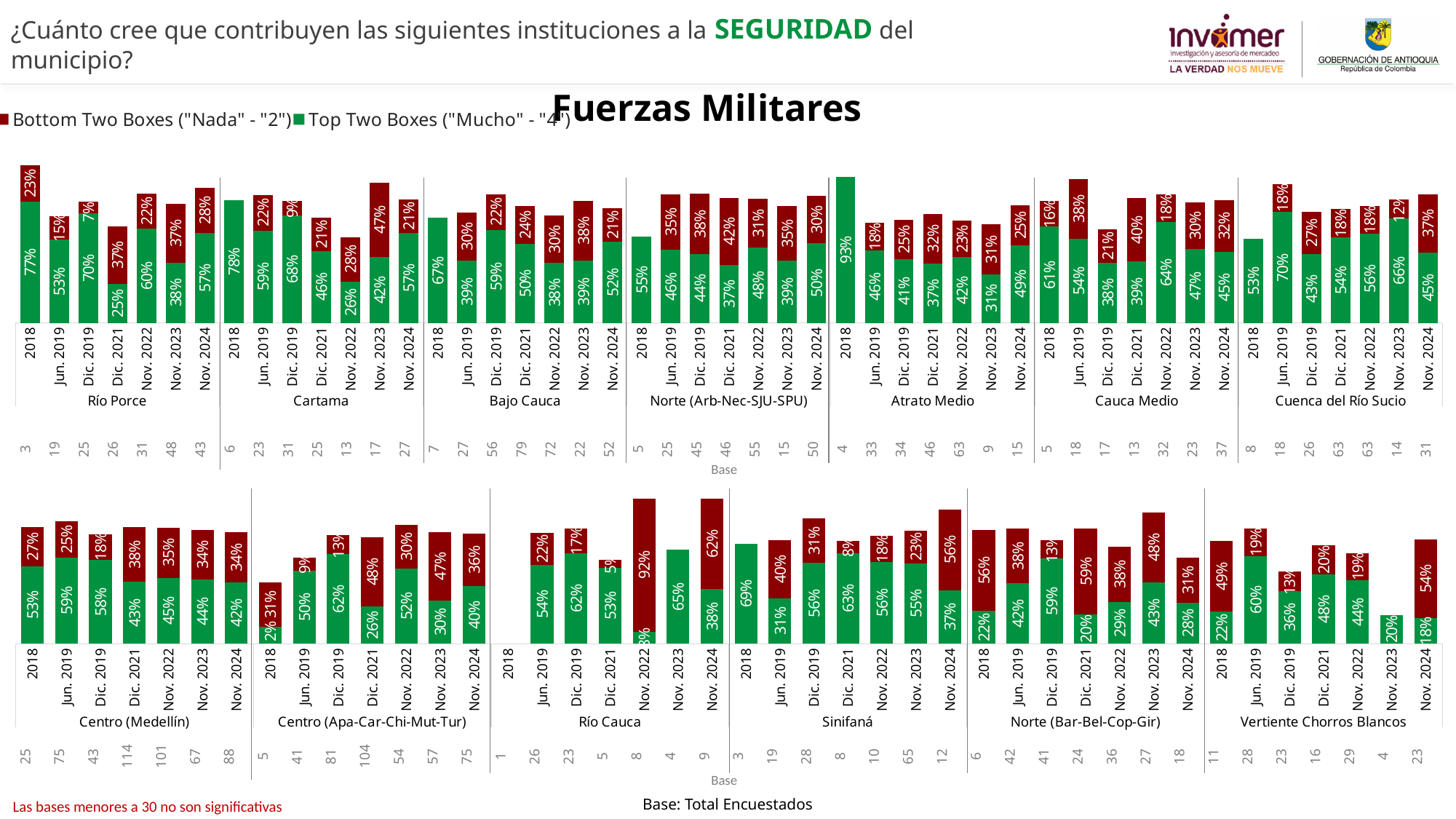
In the top chart, what is the Bottom Two Boxes value for Cartama in Nov. 2023? 47% In the top chart, what is the Top Two Boxes value for Atrato Medio in 2018? 93% In the bottom chart, which period has the lowest Top Two Boxes value for Centro (Apa-Car-Chi-Mut-Tur)? 2018 Which colour represents Top Two Boxes ("Mucho" - "4") in the legend? Green In the top chart, which is larger for Cauca Medio in Dic. 2021: the Top Two Boxes value or the Bottom Two Boxes value? Bottom Two Boxes How many series does the legend list? 2 In the bottom chart, what is the Top Two Boxes value for Sinifaná in Dic. 2021? 63% In the top chart, which period has the highest Top Two Boxes value for Río Porce? 2018 In the bottom chart, what is the Bottom Two Boxes value for Río Cauca in Nov. 2022? 92% In the bottom chart, what is the total of the stacked bar for Norte (Bar-Bel-Cop-Gir) in Dic. 2021? 79% What kind of chart is shown on the slide? Stacked bar chart In the top chart, what is the difference between the Top Two Boxes and Bottom Two Boxes values for Cuenca del Río Sucio in Nov. 2023? 54%